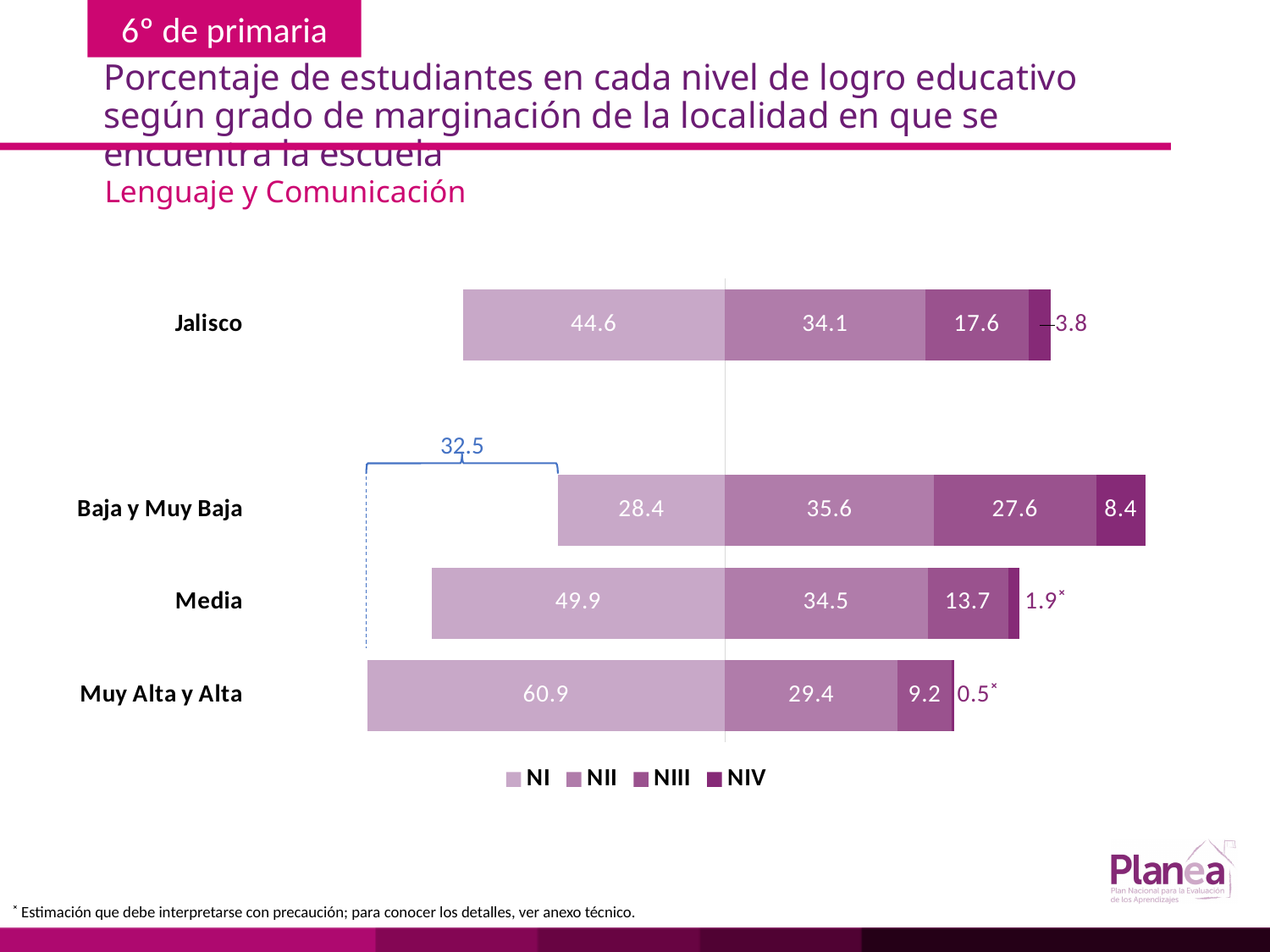
Which category has the highest NI value? Muy Alta y Alta What is the NIV value for the 'Baja y Muy Baja' category? 8.4 What is the NII value for 'Muy Alta y Alta'? 29.4 How many categories are shown on the chart? 4 How many series does the legend list? 4 What is the total of the stacked bar for 'Media'? 100.0 What is the NIII value for the 'Media' category? 13.7 What percentage of students in Jalisco are at level NI? 44.6 Which category has the lowest NIV value? Muy Alta y Alta What kind of chart is shown on the slide? Stacked bar chart Which is larger: the NIII value for Jalisco or the NIII value for 'Baja y Muy Baja'? Baja y Muy Baja What is the difference between the NI value for 'Muy Alta y Alta' and the NI value for 'Baja y Muy Baja'? 32.5